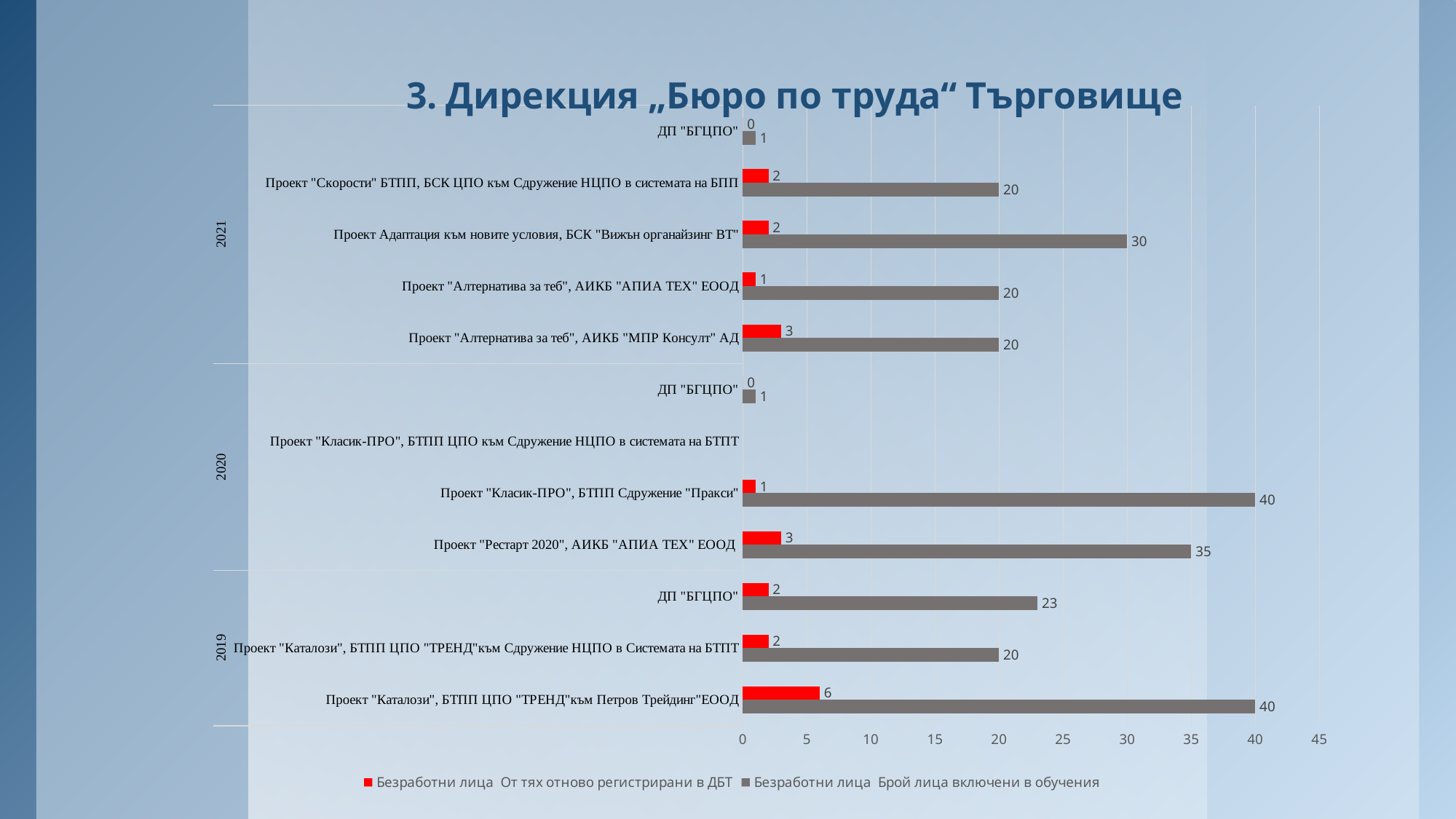
What is the value of "От тях отново регистрирани в ДБТ" for ДП "БГЦПО" in 2021? 0 What is the difference between the "От тях отново регистрирани в ДБТ" values for Проект "Алтернатива за теб", АИКБ "МПР Консулт" АД and Проект "Алтернатива за теб", АИКБ "АПИА ТЕХ" ЕООД (2021)? 2 What is the value of "От тях отново регистрирани в ДБТ" for Проект "Каталози", БТПП ЦПО "ТРЕНД"към Петров Трейдинг"ЕООД (2019)? 6 What colour are the bars for the series "Безработни лица От тях отново регистрирани в ДБТ"? red What type of chart is shown on the slide? bar chart What is the value of "Брой лица включени в обучения" for ДП "БГЦПО" in 2019? 23 What is the value of "Брой лица включени в обучения" for Проект "Рестарт 2020", АИКБ "АПИА ТЕХ" ЕООД (2020)? 35 Which category has the highest value for "От тях отново регистрирани в ДБТ"? Проект "Каталози", БТПП ЦПО "ТРЕНД"към Петров Трейдинг"ЕООД Which is larger for "Брой лица включени в обучения": Проект Адаптация към новите условия, БСК "Вижън органайзинг ВТ" (2021) or Проект "Скорости" БТПП, БСК ЦПО към Сдружение НЦПО в системата на БПП (2021)? Проект Адаптация към новите условия, БСК "Вижън органайзинг ВТ" What is the value of "Брой лица включени в обучения" for Проект Адаптация към новите условия, БСК "Вижън органайзинг ВТ" (2021)? 30 What is the difference between the "Брой лица включени в обучения" values for Проект "Класик-ПРО", БТПП Сдружение "Пракси" (2020) and Проект "Рестарт 2020", АИКБ "АПИА ТЕХ" ЕООД (2020)? 5 How many series does the legend list? 2